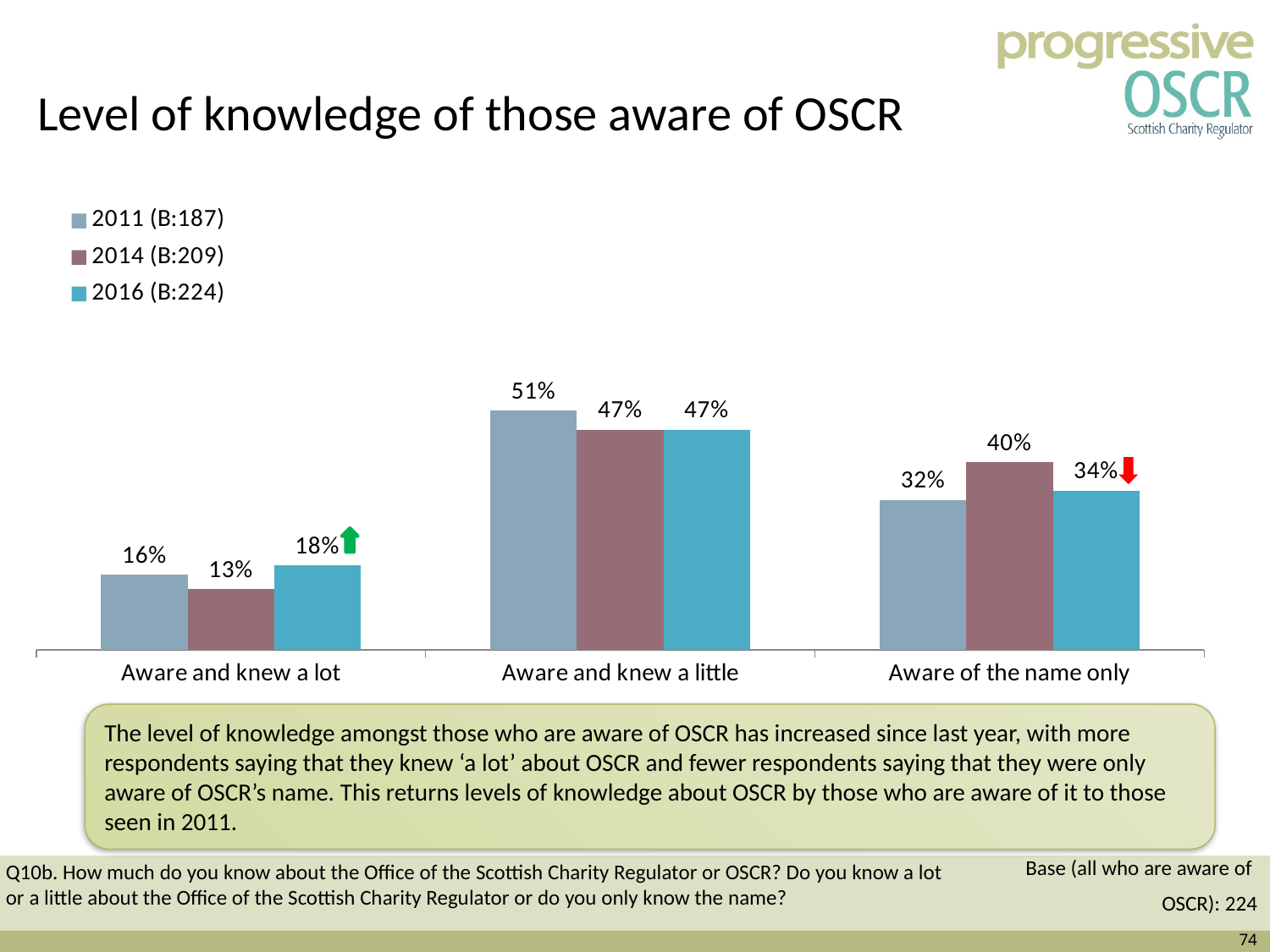
Which category has the lowest value for the 2014 (B:209) series? Aware and knew a lot What is the value for 2016 (B:224) in the 'Aware and knew a lot' category? 18% Which is larger in the 'Aware and knew a lot' category: the 2011 (B:187) value or the 2014 (B:209) value? 2011 (B:187) What kind of chart is shown on the slide? Bar chart What is the difference between the 2014 (B:209) and 2016 (B:224) values in the 'Aware of the name only' category? 6% How many series does the legend list? 3 How many categories are shown on the x axis? 3 Which category has the highest value for the 2016 (B:224) series? Aware and knew a little What is the difference between the 2011 (B:187) and 2016 (B:224) values in the 'Aware and knew a little' category? 4% What is the value for 2014 (B:209) in the 'Aware of the name only' category? 40% What is the title of the slide? Level of knowledge of those aware of OSCR What is the value for 2011 (B:187) in the 'Aware and knew a little' category? 51%